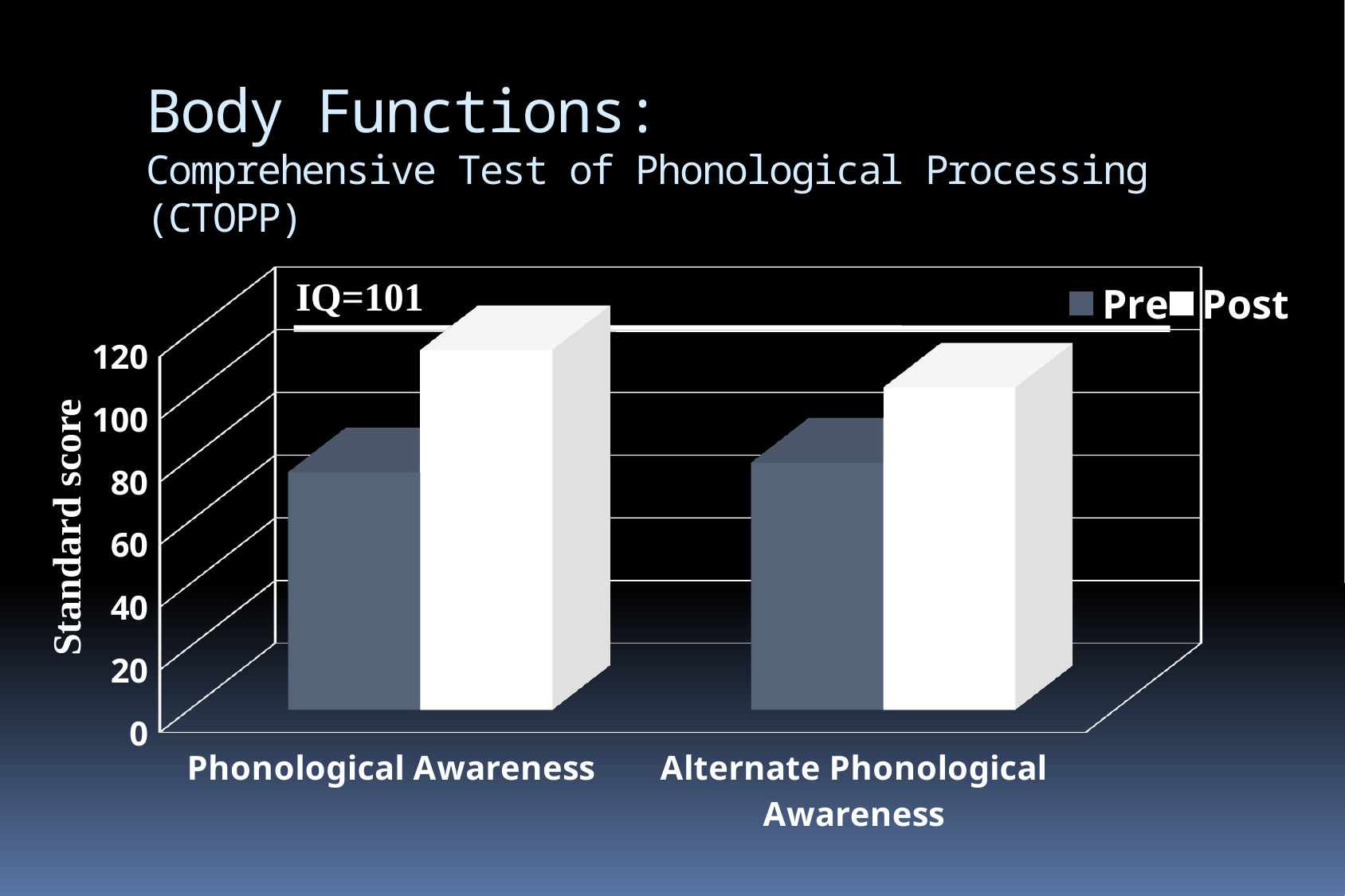
What is the label of the vertical axis of the chart? Standard score Is the Pre value for Phonological Awareness greater or less than 100? less Is the Pre value for Alternate Phonological Awareness greater or less than 100? less For Alternate Phonological Awareness, which is larger, the Pre value or the Post value? Post What kind of chart is shown on the slide? bar chart What value is given for IQ in the annotation on the chart? IQ=101 How many categories are shown on the x axis of the chart? 2 For Phonological Awareness, which is larger, the Pre value or the Post value? Post Is the Post value for Phonological Awareness greater or less than 100? greater Which category has the higher Post value? Phonological Awareness How many series does the chart's legend list? 2